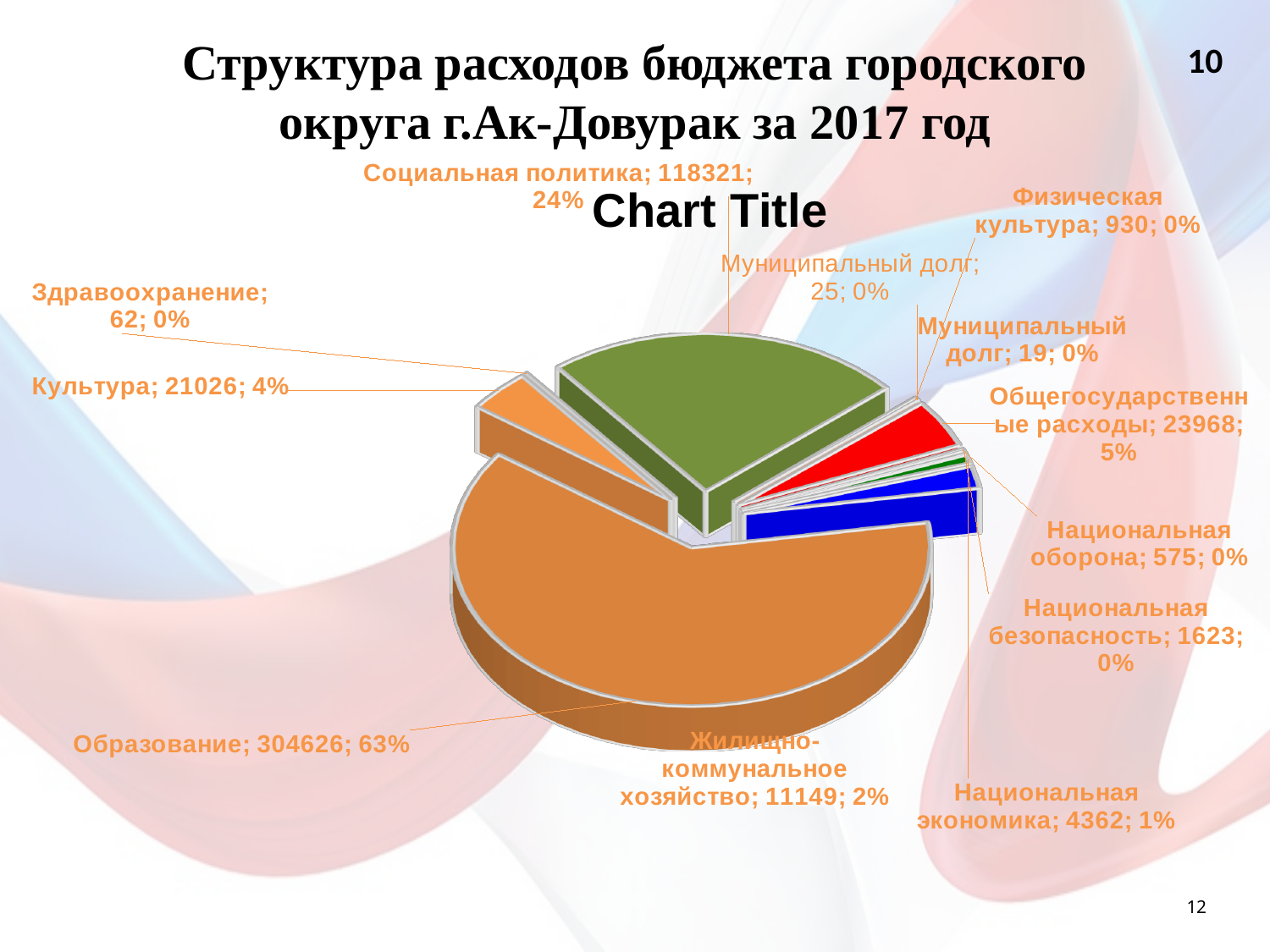
What is the value for Национальная безопасность? 1623 Which category has the largest value? Образование What is the title printed above the pie chart? Chart Title What is the value for Культура? 21026 What is the value for Образование? 304626 What kind of chart is shown on the slide? pie chart Which is larger, the value for Общегосударственные расходы or the value for Культура? Общегосударственные расходы What is the difference between the values for Образование and Социальная политика? 186305 What is the value for Социальная политика? 118321 What is the difference between the values for Культура and Жилищно-коммунальное хозяйство? 9877 What share of the pie does Образование take? 63% What share of the pie does Социальная политика take? 24%